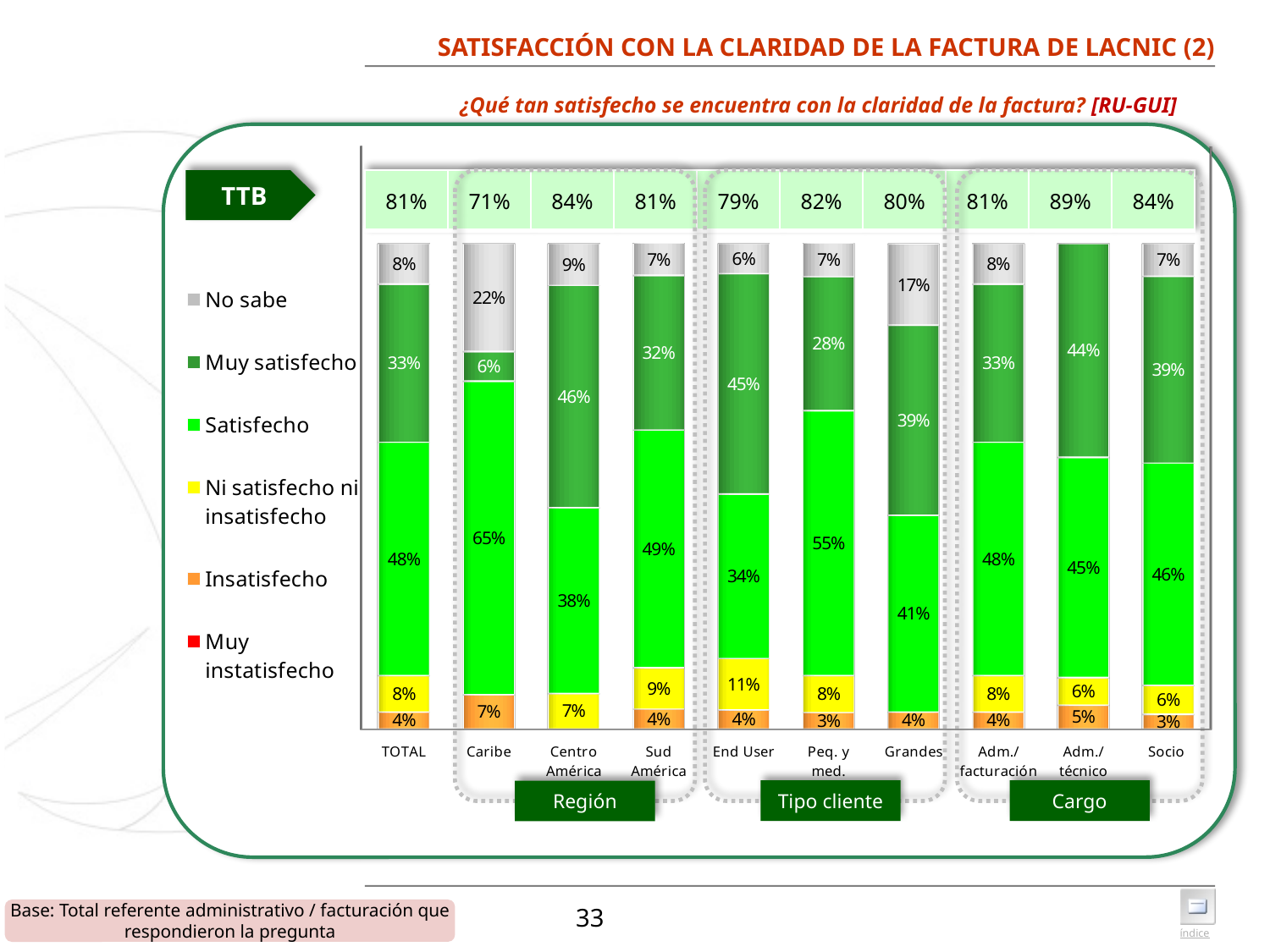
What is the 'Ni satisfecho ni insatisfecho' value for End User? 11% What is the 'No sabe' value for Grandes? 17% What kind of chart is shown on the slide? stacked bar chart Which is larger, the 'Muy satisfecho' value for Adm./técnico or for Socio? Adm./técnico Which category has the lowest 'Muy satisfecho' value? Caribe Which category has the highest 'Satisfecho' value? Caribe What is the 'Muy satisfecho' value for Centro América? 46% What is the 'Satisfecho' value for Caribe? 65% How many categories (bars) are plotted along the x axis? 10 What is the difference between the 'Satisfecho' values for Peq. y med. and End User? 21% How many series does the legend list? 6 What is the TTB value shown for Adm./técnico? 89%